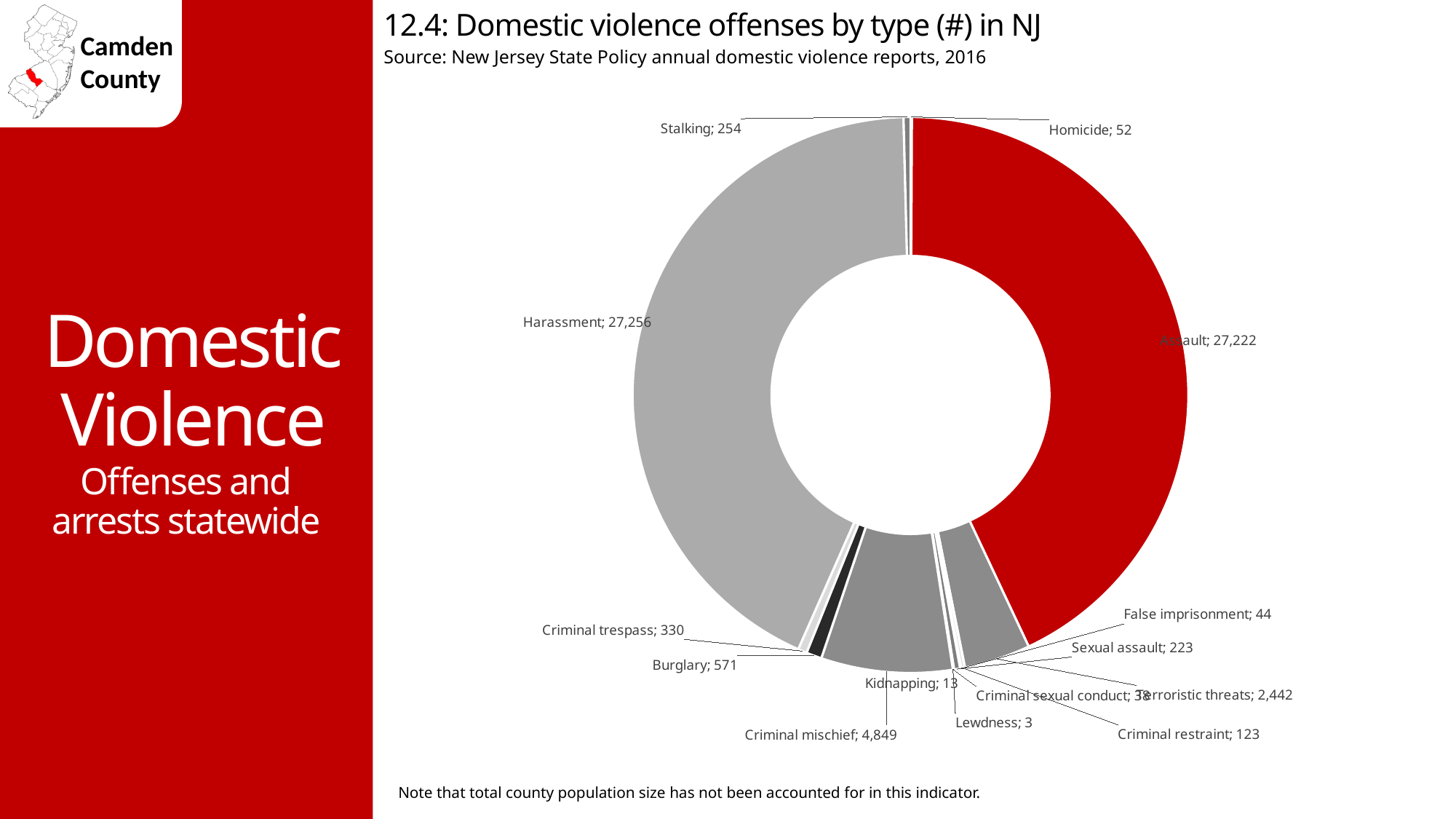
What is the difference between the Burglary value and the Criminal trespass value? 241 How many offense types are shown on the chart? 14 What value is shown for Terroristic threats? 2,442 Which offense type has the lowest value on the chart? Lewdness What is the difference between the Criminal mischief value and the Terroristic threats value? 2,407 What value is shown for Homicide? 52 What is the number of Harassment offenses shown on the chart? 27,256 What is the number of Assault offenses shown on the chart? 27,222 How many Criminal mischief offenses are shown on the chart? 4,849 Which is larger, the value for Burglary or the value for Criminal trespass? Burglary What is the title of the chart? 12.4: Domestic violence offenses by type (#) in NJ What kind of chart is shown on the slide? Doughnut chart